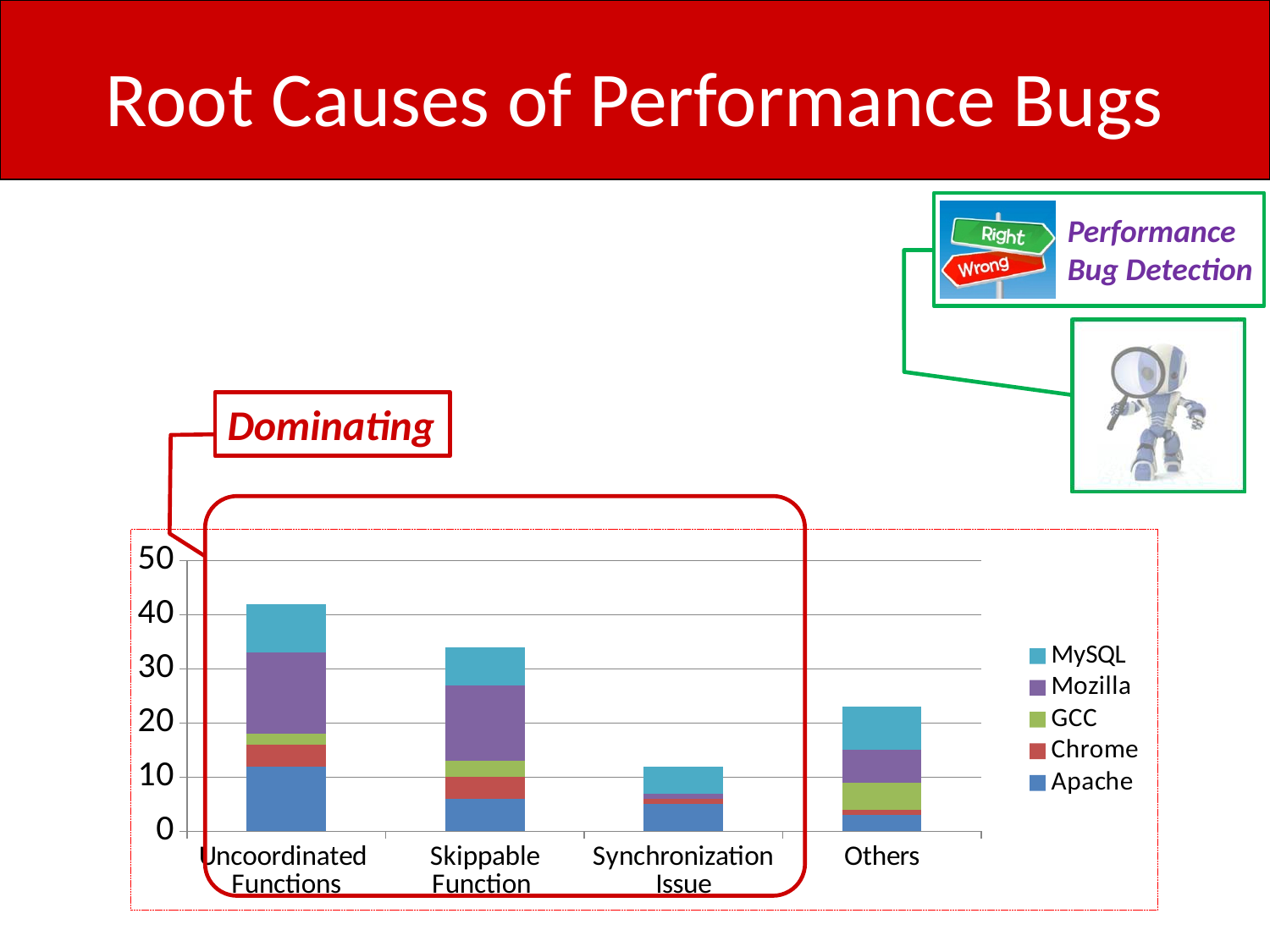
Which stacked bar is taller, Skippable Function or Others? Skippable Function How many categories are shown on the x axis of the chart? 4 How many series does the chart's legend list? 5 Which series is listed first (at the top) in the chart's legend? MySQL Which category has the shortest stacked bar? Synchronization Issue What kind of chart is shown on the slide? stacked bar chart Is the total stacked bar for Others greater or less than 20? greater Which series is shown at the bottom of each stacked bar? Apache Is the total stacked bar for Synchronization Issue greater or less than 20? less Is the total stacked bar for Uncoordinated Functions greater or less than 40? greater Which category has the tallest stacked bar? Uncoordinated Functions